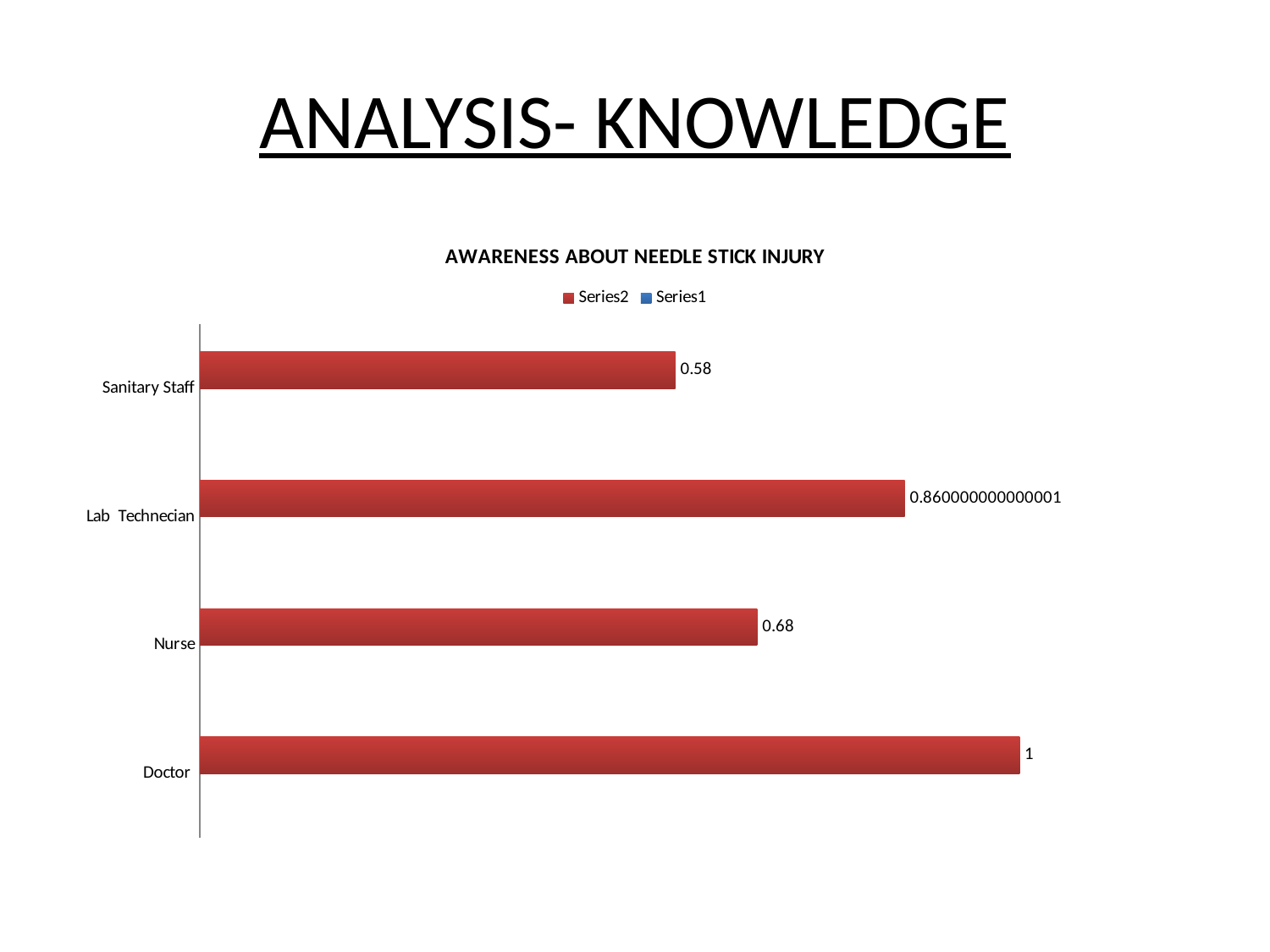
What is the difference between the values for Doctor and Sanitary Staff? 0.42 What data label is shown for Lab Technecian in the chart? 0.860000000000001 What is the value for Sanitary Staff in the chart? 0.58 Which has a larger value, Nurse or Lab Technecian? Lab Technecian How many categories are shown in the chart? 4 How many series does the legend list? 2 What is the value for Nurse in the chart? 0.68 Which category has the lowest value in the chart? Sanitary Staff Which category has the highest value in the chart? Doctor What type of chart is shown on the slide? Bar chart What is the difference between the values for Nurse and Sanitary Staff? 0.1 What is the value for Doctor in the chart? 1